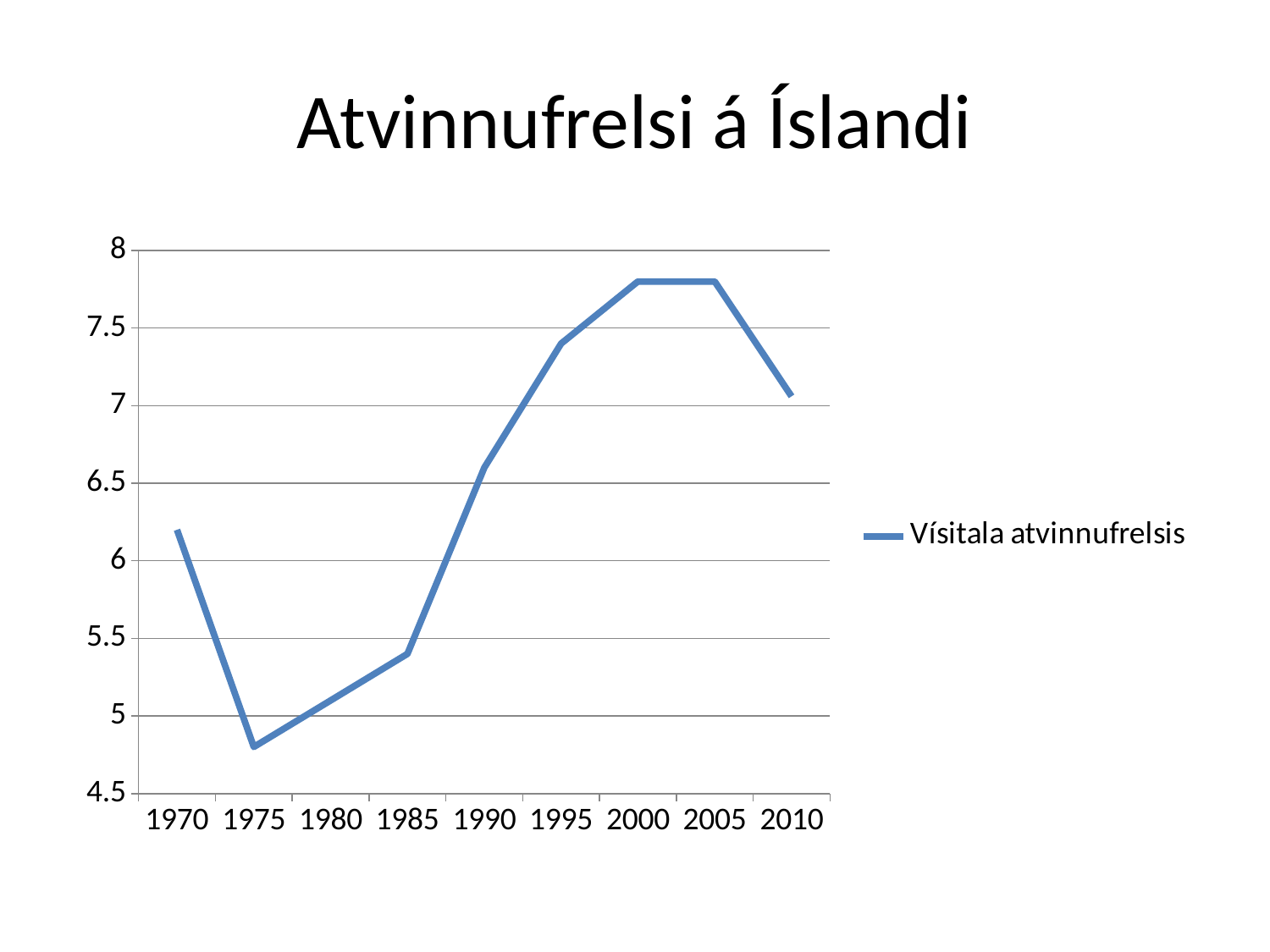
How many series does the legend list? 1 In which year is the value lowest? 1975 Do the values rise or fall from 1975 to 2000? rise Which year has the larger value, 1985 or 1995? 1995 How many years are plotted on the x axis? 9 Is the value for 1975 greater or less than 5? less Is the value for 1970 greater or less than 6? greater What kind of chart is shown on the slide? line chart Is the value for 1990 greater or less than 6.5? greater What is the title of the slide? Atvinnufrelsi á Íslandi What series name does the legend list? Vísitala atvinnufrelsis